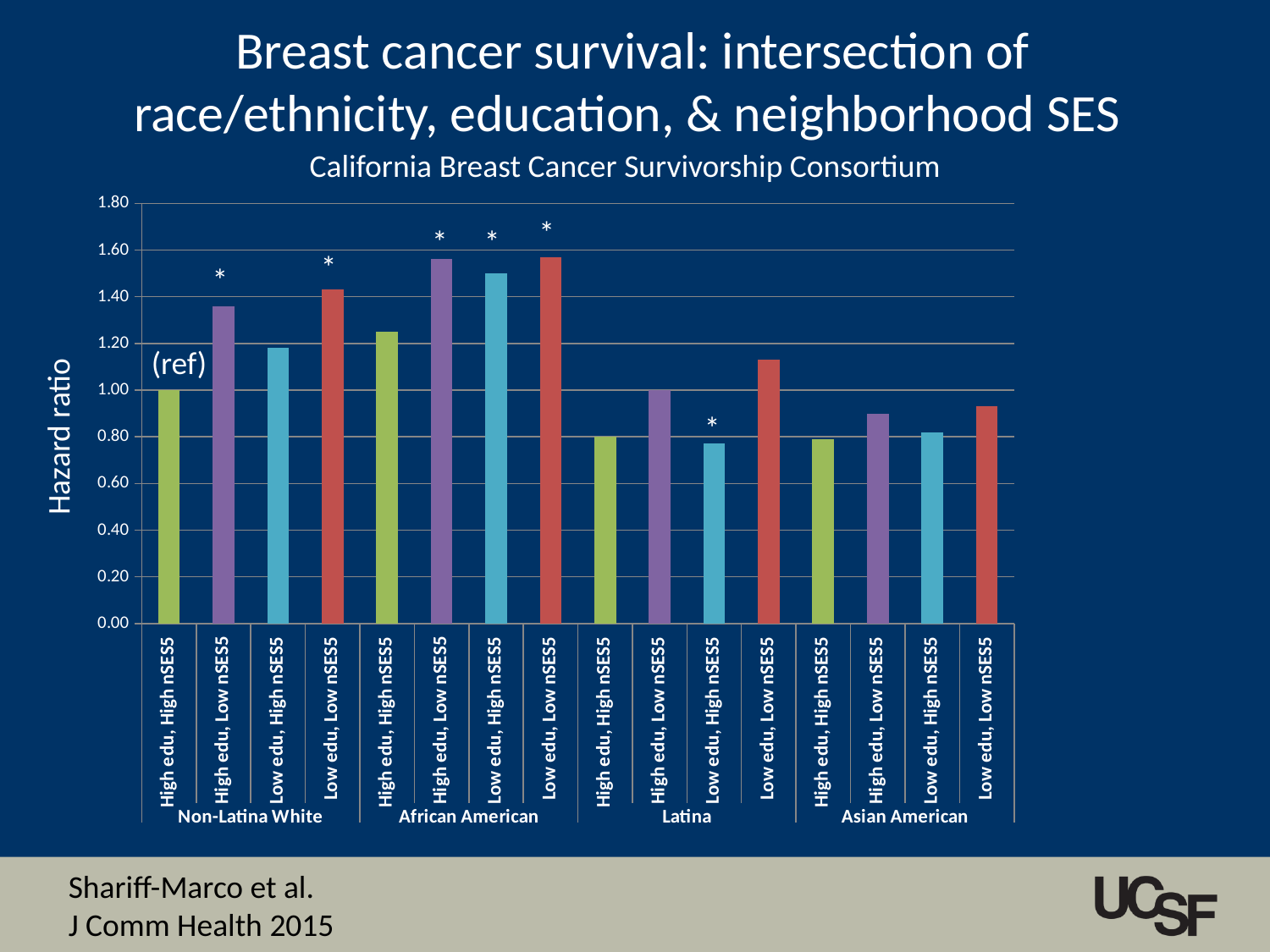
Which race/ethnicity group contains the tallest bar in the chart? African American What is the hazard ratio for the Non-Latina White, High edu, High nSES group? 1.00 Which has the higher hazard ratio: Non-Latina White, Low edu, Low nSES or Latina, Low edu, Low nSES? Non-Latina White, Low edu, Low nSES What kind of chart is shown on the slide? Bar chart What is the label on the y axis of the chart? Hazard ratio Is the hazard ratio for Non-Latina White, Low edu, Low nSES greater or less than 1.20? greater How many bars are plotted in the chart? 16 Is the hazard ratio for African American, Low edu, Low nSES greater or less than 1.40? greater Which bar is labeled "(ref)"? Non-Latina White, High edu, High nSES How many race/ethnicity groups are shown along the x axis? 4 Which has the higher hazard ratio: African American, High edu, High nSES or Asian American, High edu, High nSES? African American, High edu, High nSES Is the hazard ratio for Latina, Low edu, High nSES greater or less than 1.00? less